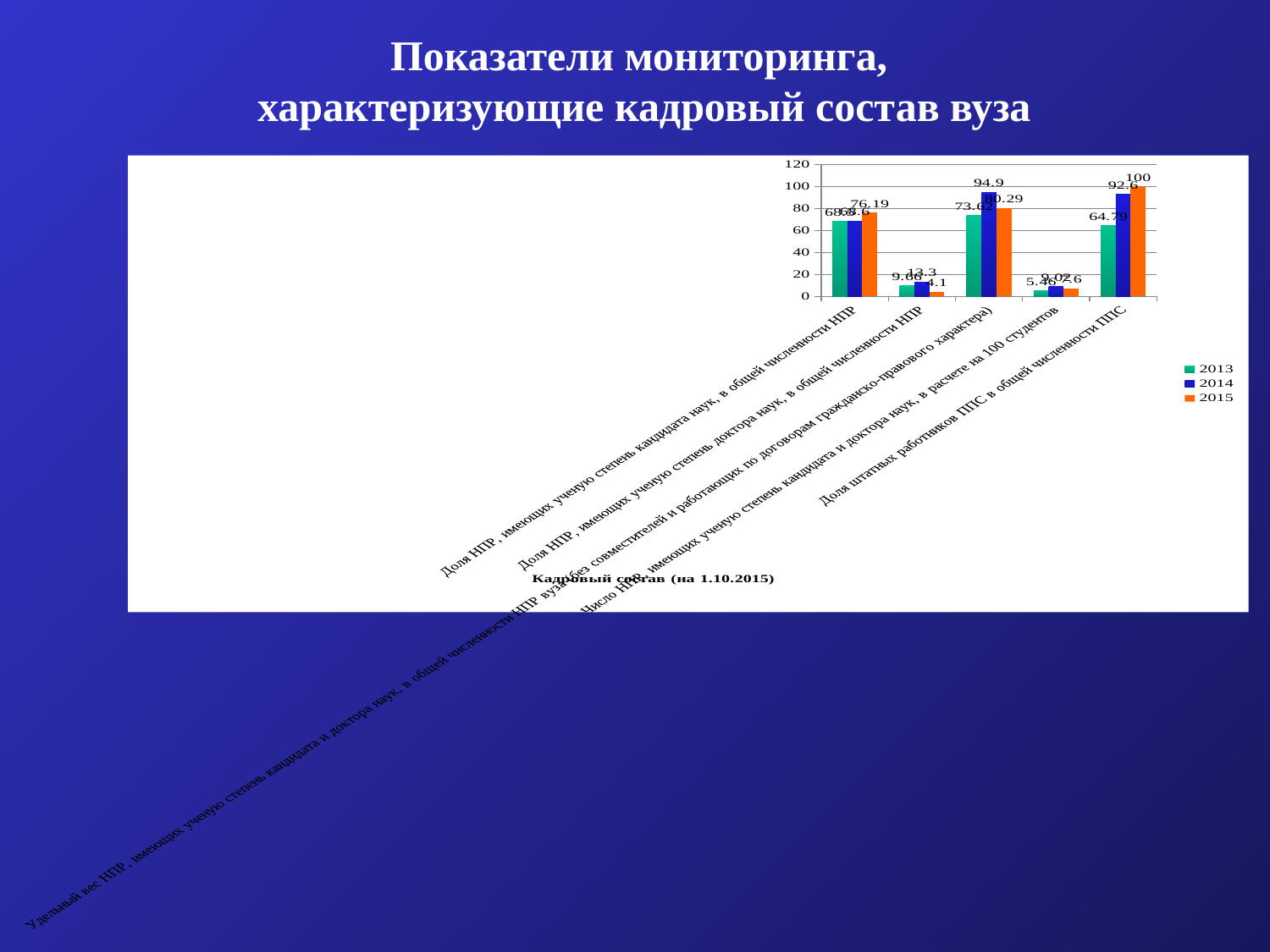
Which category has the highest 2015 value? Доля штатных работников ППС в общей численности ППС What is the 2013 value for 'Доля штатных работников ППС в общей численности ППС'? 64.79 What is the 2015 value for 'Доля НПР, имеющих ученую степень кандидата наук, в общей численности НПР'? 76.19 How many categories are plotted on the x axis? 5 What is the 2014 value for 'Доля НПР, имеющих ученую степень доктора наук, в общей численности НПР'? 13.3 What is the 2014 value for 'Число НПР, имеющих ученую степень кандидата и доктора наук, в расчете на 100 студентов'? 9.02 Which year has the larger value for 'Доля штатных работников ППС в общей численности ППС', 2013 or 2014? 2014 What is the difference between the 2015 and 2013 values for 'Доля штатных работников ППС в общей численности ППС'? 35.21 What type of chart is shown on the slide? bar chart What is the 2015 value for 'Доля штатных работников ППС в общей численности ППС'? 100 Is the 2013 value for 'Доля НПР, имеющих ученую степень кандидата наук, в общей численности НПР' greater or less than 60? greater How many series does the legend list? 3